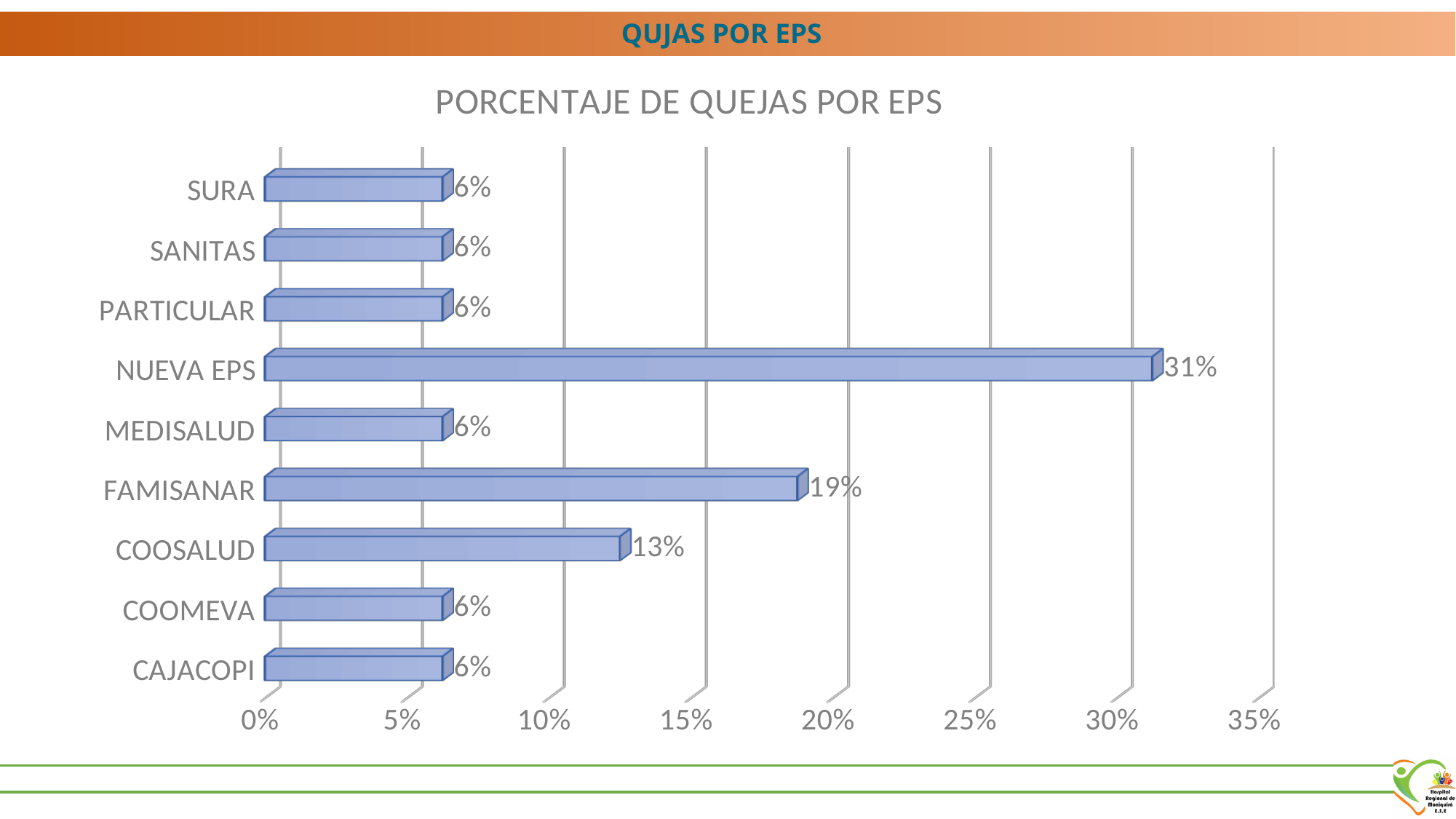
What is the value for SURA? 6% What is the difference between the values for NUEVA EPS and FAMISANAR? 12% Which is larger, the value for COOSALUD or the value for MEDISALUD? COOSALUD What is the title of the chart? PORCENTAJE DE QUEJAS POR EPS Is the value for NUEVA EPS greater or less than 30%? greater What is the difference between the values for FAMISANAR and COOSALUD? 6% What kind of chart is shown on the slide? Bar chart Which category has the highest value? NUEVA EPS How many categories are shown in the chart? 9 What is the value for FAMISANAR? 19% What is the value for COOSALUD? 13% What is the value for NUEVA EPS? 31%